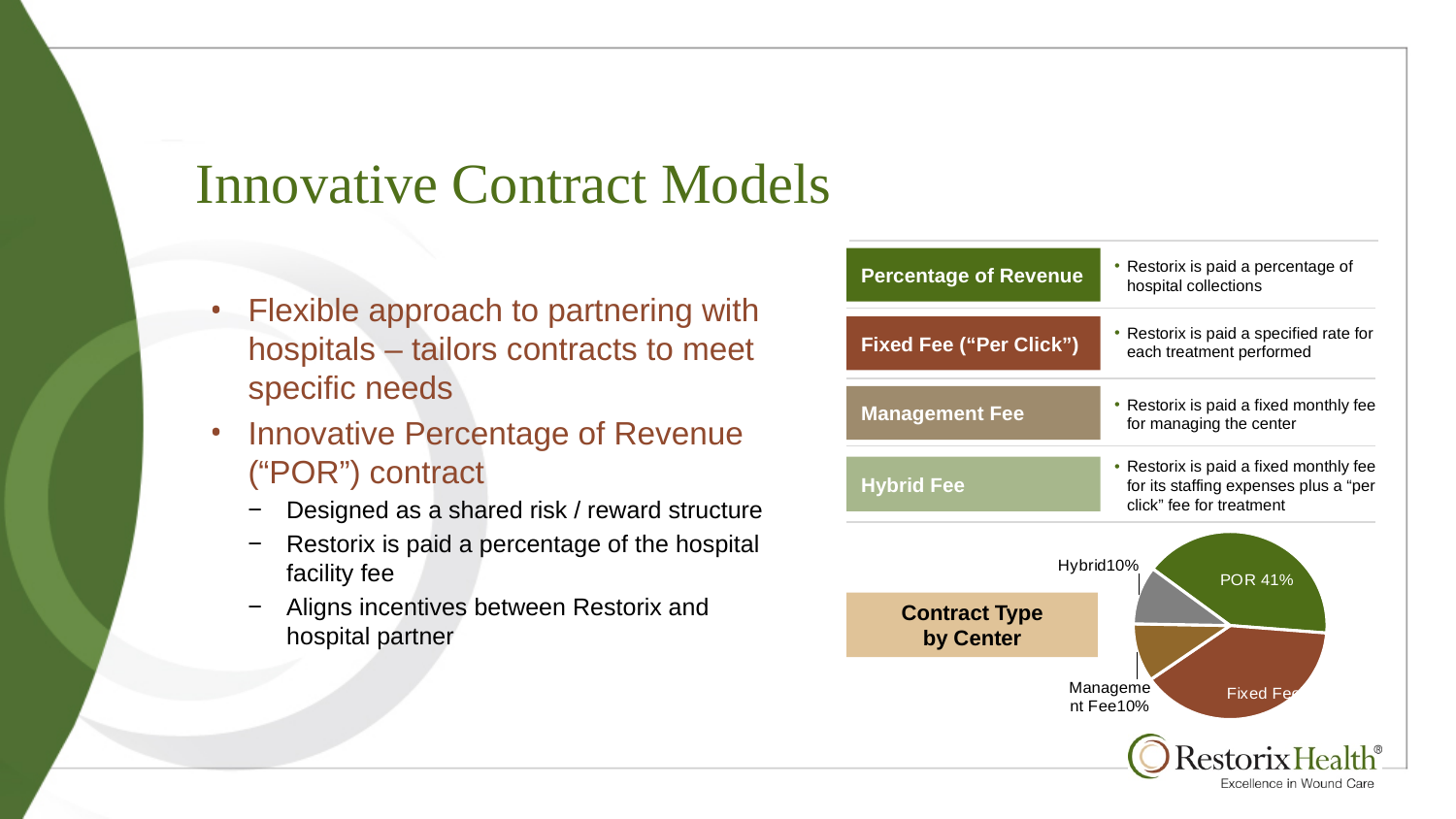
What percentage does the Management Fee slice show in the pie chart? 10% What is the title of the pie chart? Contract Type by Center What is the difference in percentage points between the POR slice and the Hybrid slice? 31 What percentage does the Hybrid slice show in the pie chart? 10% What share of the pie does the Hybrid slice represent? 10% What kind of chart is shown on the slide? pie chart What colour is the POR slice in the pie chart? green Which slice is larger in the pie chart, POR or Hybrid? POR What percentage of centers use the POR contract type according to the pie chart? 41% Which slice is larger in the pie chart, Management Fee or POR? POR How many slices does the pie chart have? 4